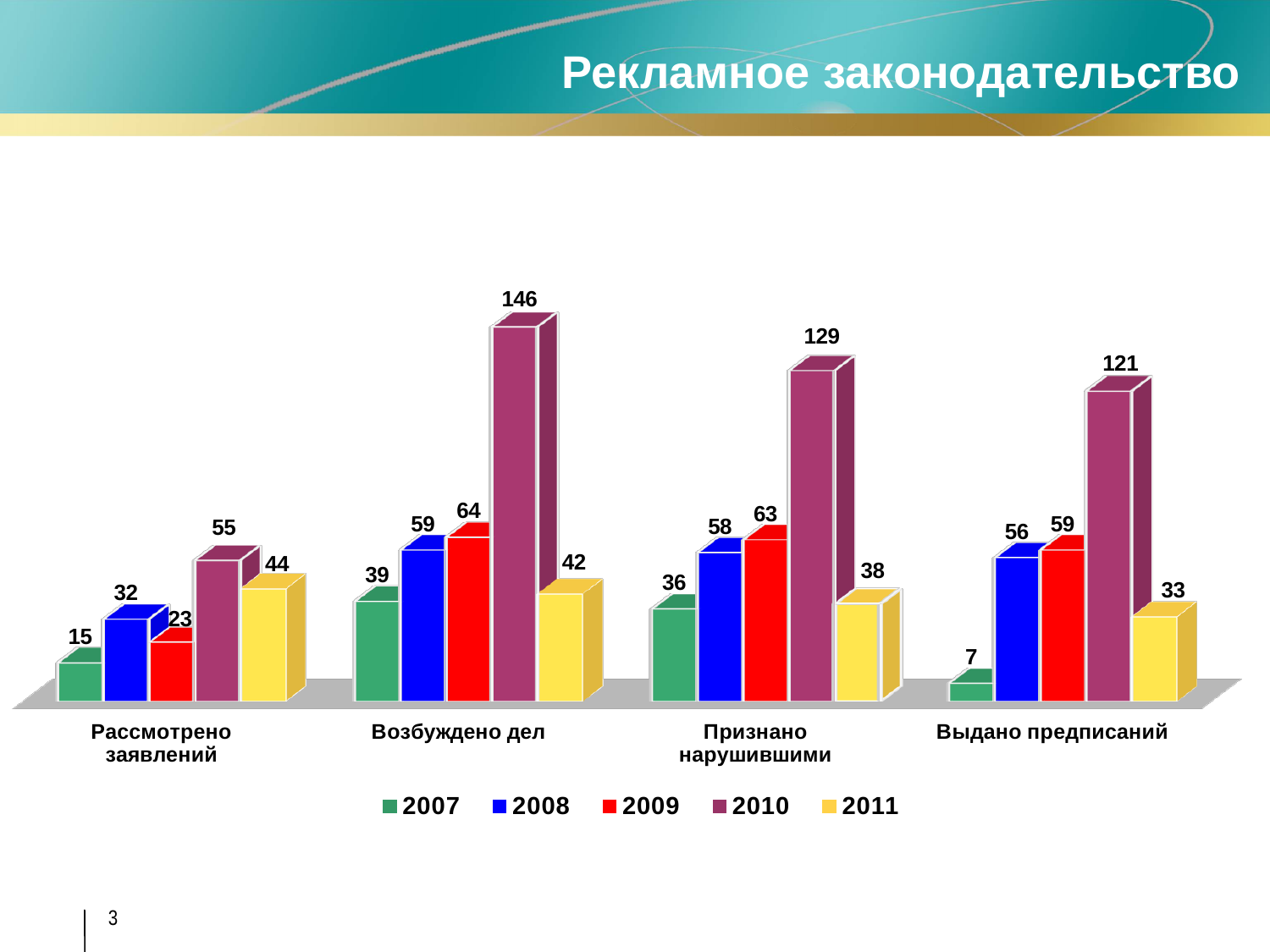
Which year has the lowest value in the "Рассмотрено заявлений" category? 2007 What is the value for 2007 in the "Выдано предписаний" category? 7 What is the value for 2010 in the "Возбуждено дел" category? 146 What kind of chart is shown on the slide? bar chart Which is larger in the "Возбуждено дел" category: the value for 2008 or the value for 2009? 2009 What is the title of the slide containing the chart? Рекламное законодательство What is the value for 2011 in the "Рассмотрено заявлений" category? 44 What is the difference between the 2010 and 2011 values in the "Выдано предписаний" category? 88 What is the difference between the 2009 and 2007 values in the "Признано нарушившими" category? 27 How many categories are shown on the x axis? 4 Which year has the highest value in the "Признано нарушившими" category? 2010 How many series does the legend list? 5